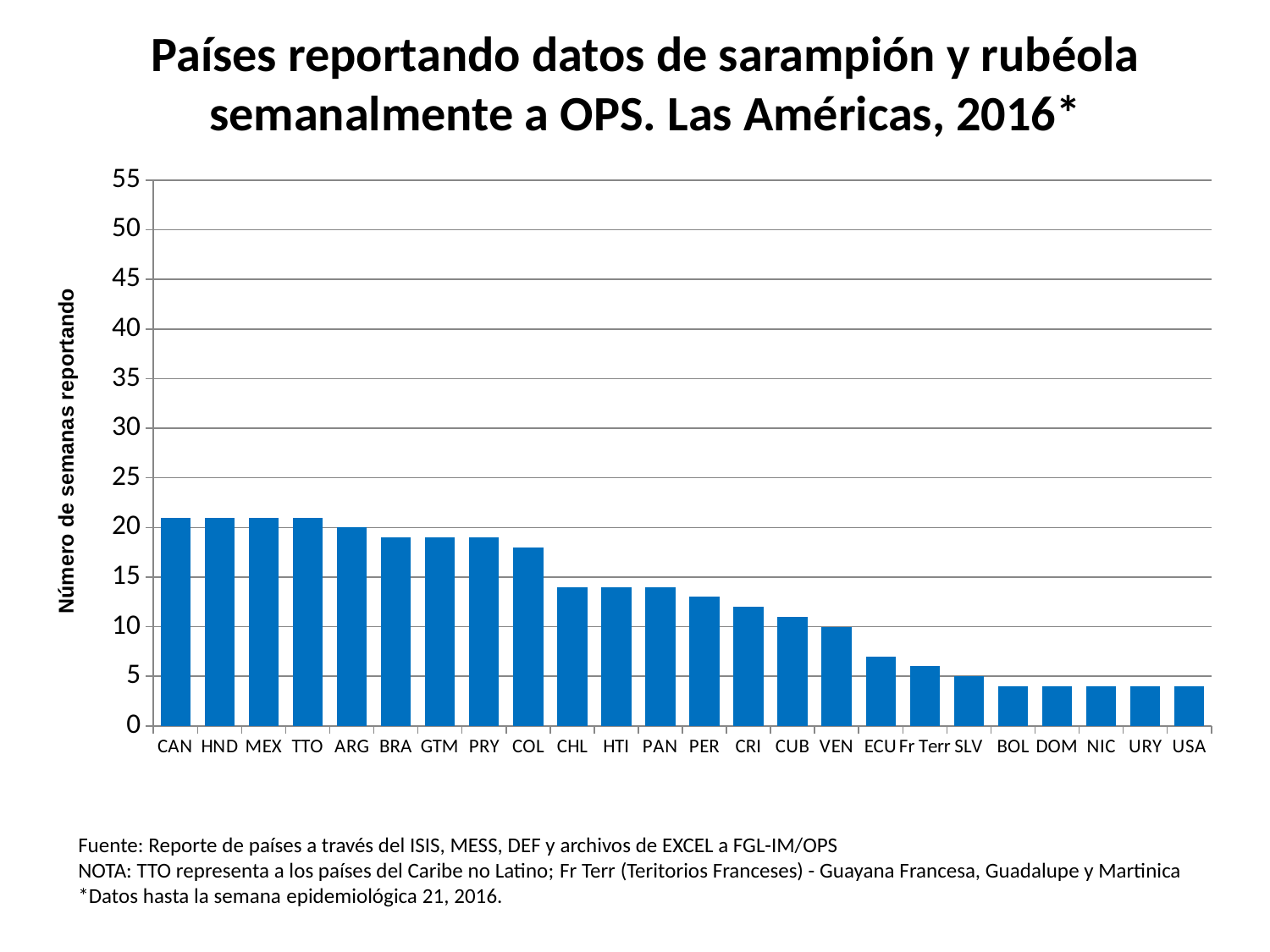
Is the value for CHL greater or less than 15? less Do the values generally rise or fall moving from left to right along the x axis? Fall What is the value for SLV in the chart? 5 How many countries or territories are shown on the x axis of the chart? 24 What is the value for ARG in the chart? 20 Is the value for ECU greater or less than 5? greater What kind of chart is shown on the slide? Bar chart What is the value for VEN in the chart? 10 What is the label of the y axis of the chart? Número de semanas reportando Which has a larger value, COL or CHL? COL Is the value for USA greater or less than 5? less